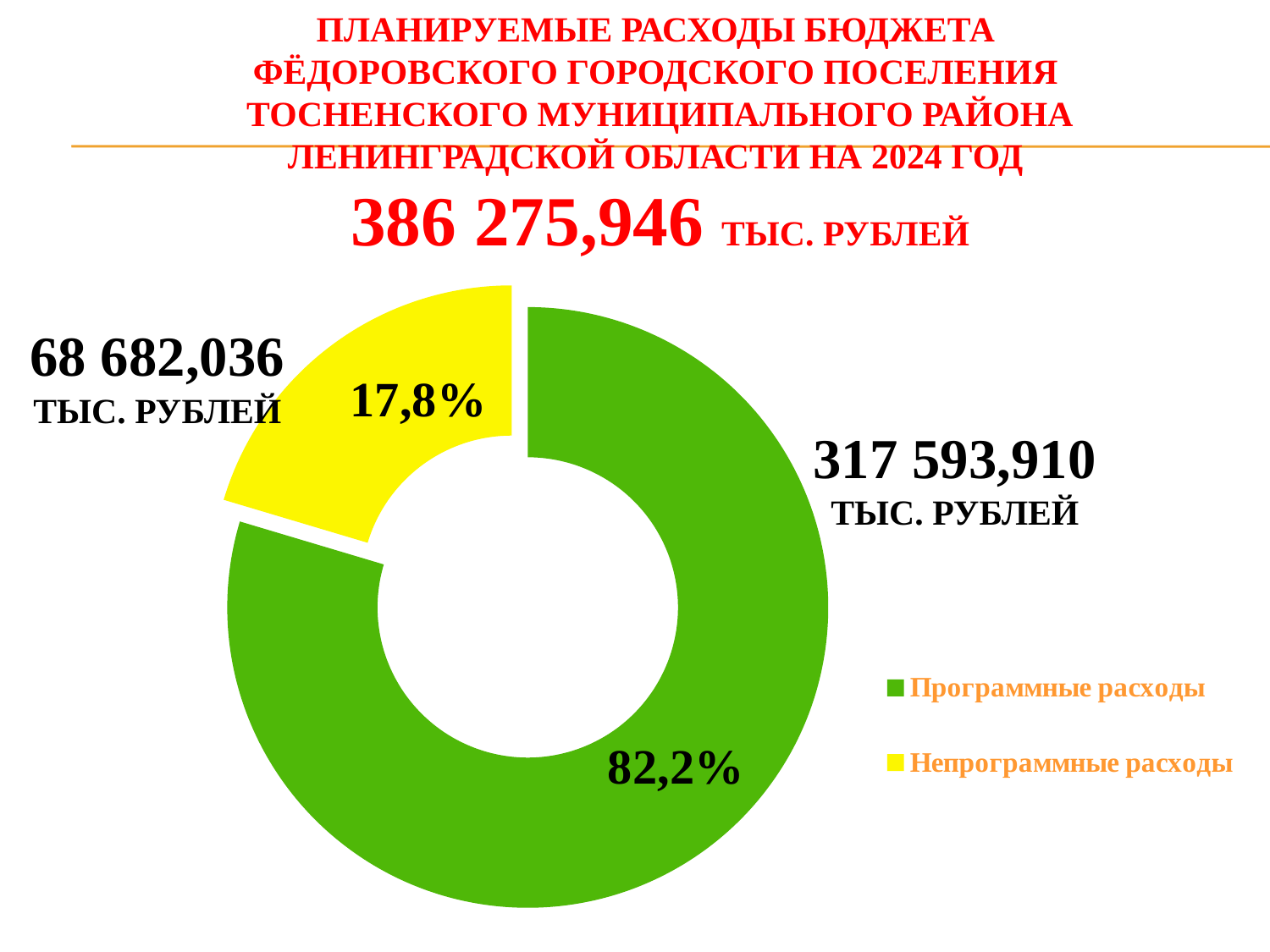
How many categories does the chart show? 2 What is the difference between the values for Программные расходы and Непрограммные расходы, in тыс. рублей? 248 911,874 Which is larger, Программные расходы or Непрограммные расходы? Программные расходы Which category has the largest slice? Программные расходы What share of the chart does Непрограммные расходы take? 17,8% What is the difference in percentage points between the Программные расходы and Непрограммные расходы shares? 64,4 What kind of chart is shown on the slide? Doughnut (pie) chart What is the value shown for Программные расходы? 317 593,910 тыс. рублей What is the value shown for Непрограммные расходы? 68 682,036 тыс. рублей What share of the chart does Программные расходы take? 82,2% Which category has the smallest slice? Непрограммные расходы What is the total of the two categories shown, in тыс. рублей? 386 275,946